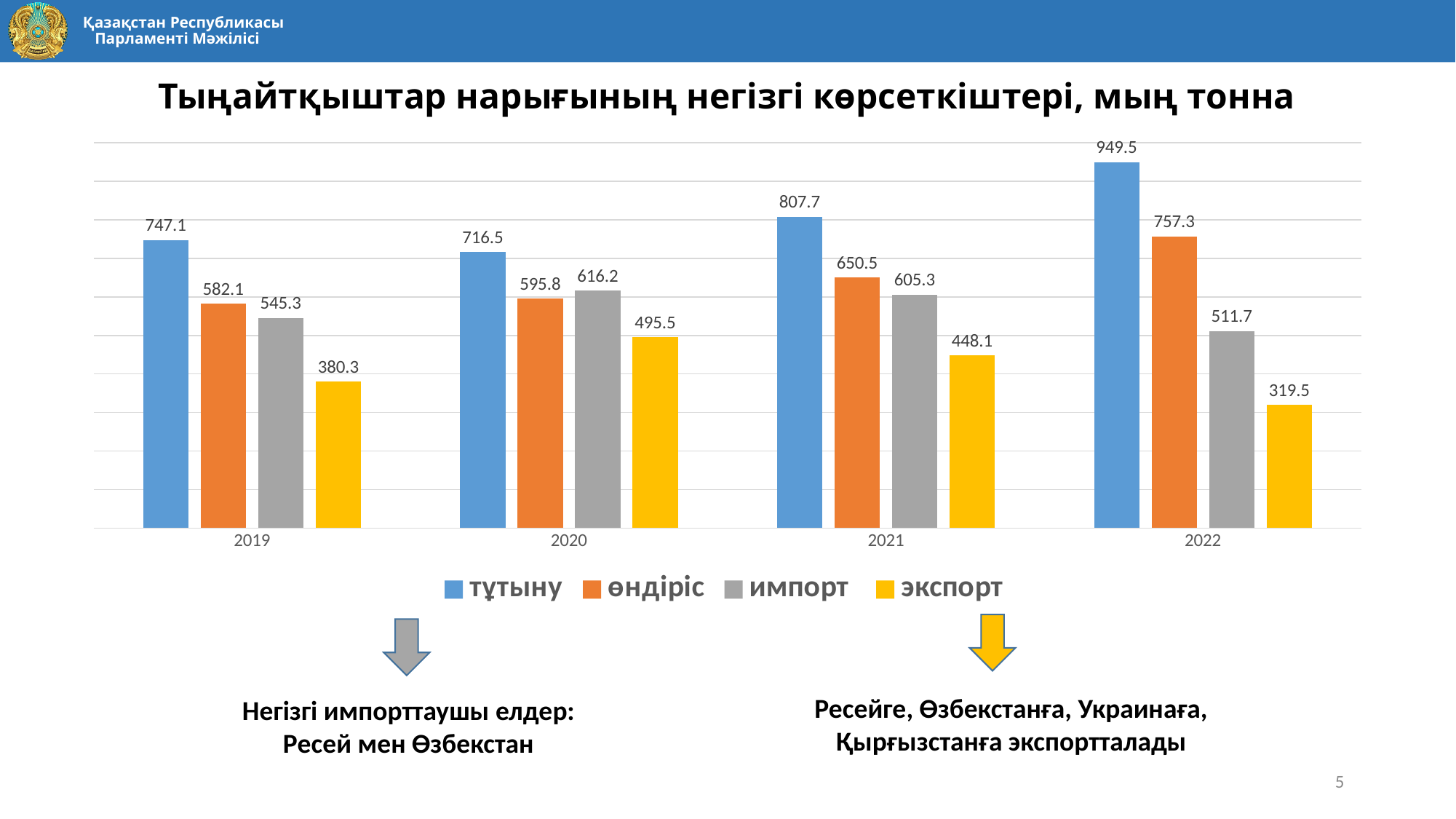
What kind of chart is shown on the slide? bar chart What is the difference between тұтыну and өндіріс in 2022? 192.2 What is the value for экспорт in 2019? 380.3 What is the value for тұтыну in 2022? 949.5 What is the value for өндіріс in 2021? 650.5 Does the value for экспорт rise or fall from 2020 to 2022? fall In which year is тұтыну highest? 2022 What is the value for импорт in 2020? 616.2 How many series does the legend list? 4 How many years are shown on the x axis? 4 In which year is экспорт lowest? 2022 Which is larger in 2020: өндіріс or импорт? импорт